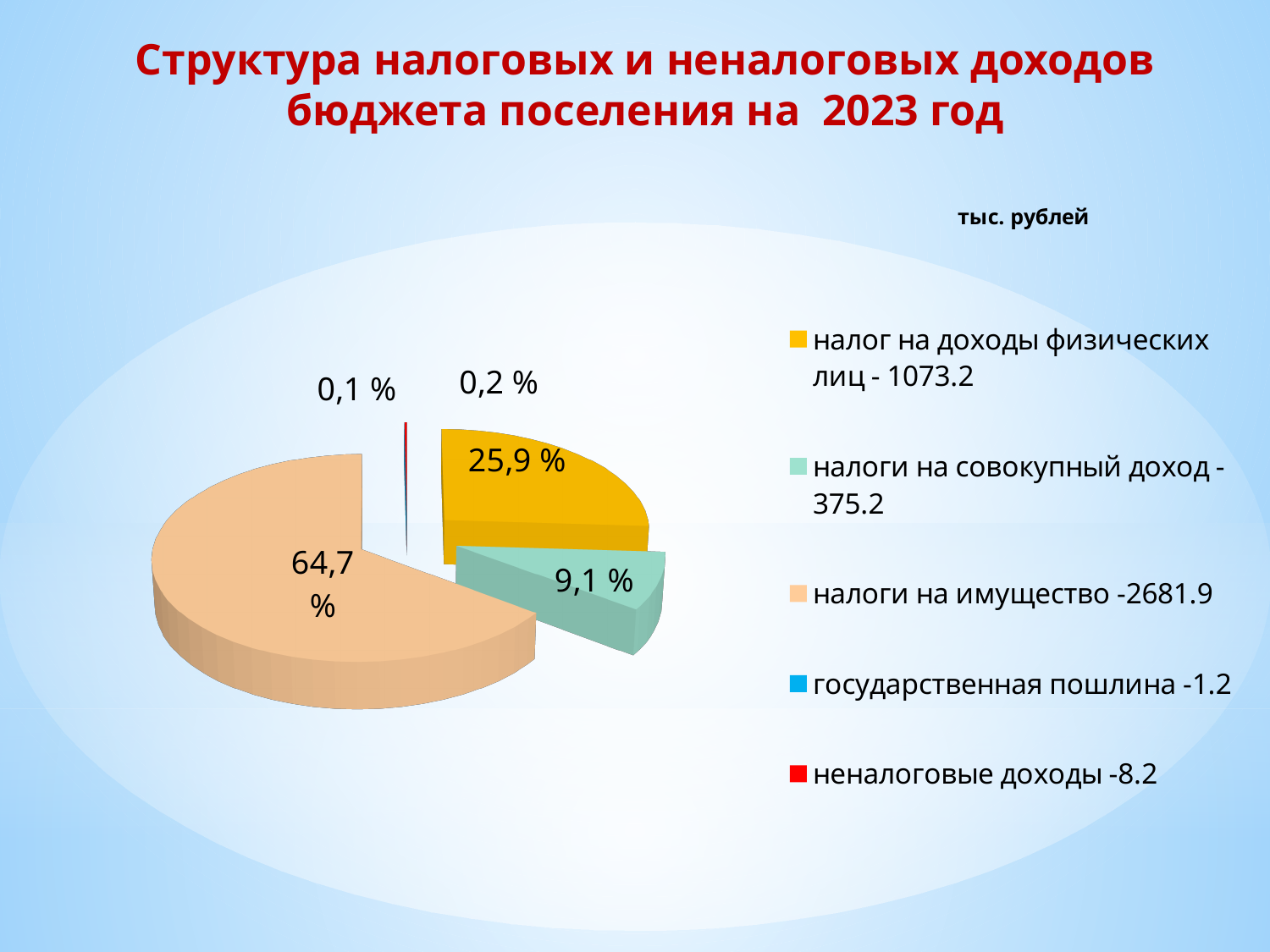
How many categories does the legend list? 5 What share of the pie does "налог на доходы физических лиц" hold? 25,9 % What value is given in the legend for "налоги на совокупный доход"? 375.2 What value is given in the legend for "государственная пошлина"? 1.2 What share of the pie does "налоги на имущество" hold? 64,7 % What kind of chart is shown on the slide? pie chart What share of the pie does "налоги на совокупный доход" hold? 9,1 % What value is given in the legend for "налог на доходы физических лиц"? 1073.2 What unit is stated above the legend? тыс. рублей What value is given in the legend for "неналоговые доходы"? 8.2 Which is larger, the share for "налог на доходы физических лиц" or the share for "налоги на совокупный доход"? налог на доходы физических лиц Which category has the largest slice of the pie? налоги на имущество